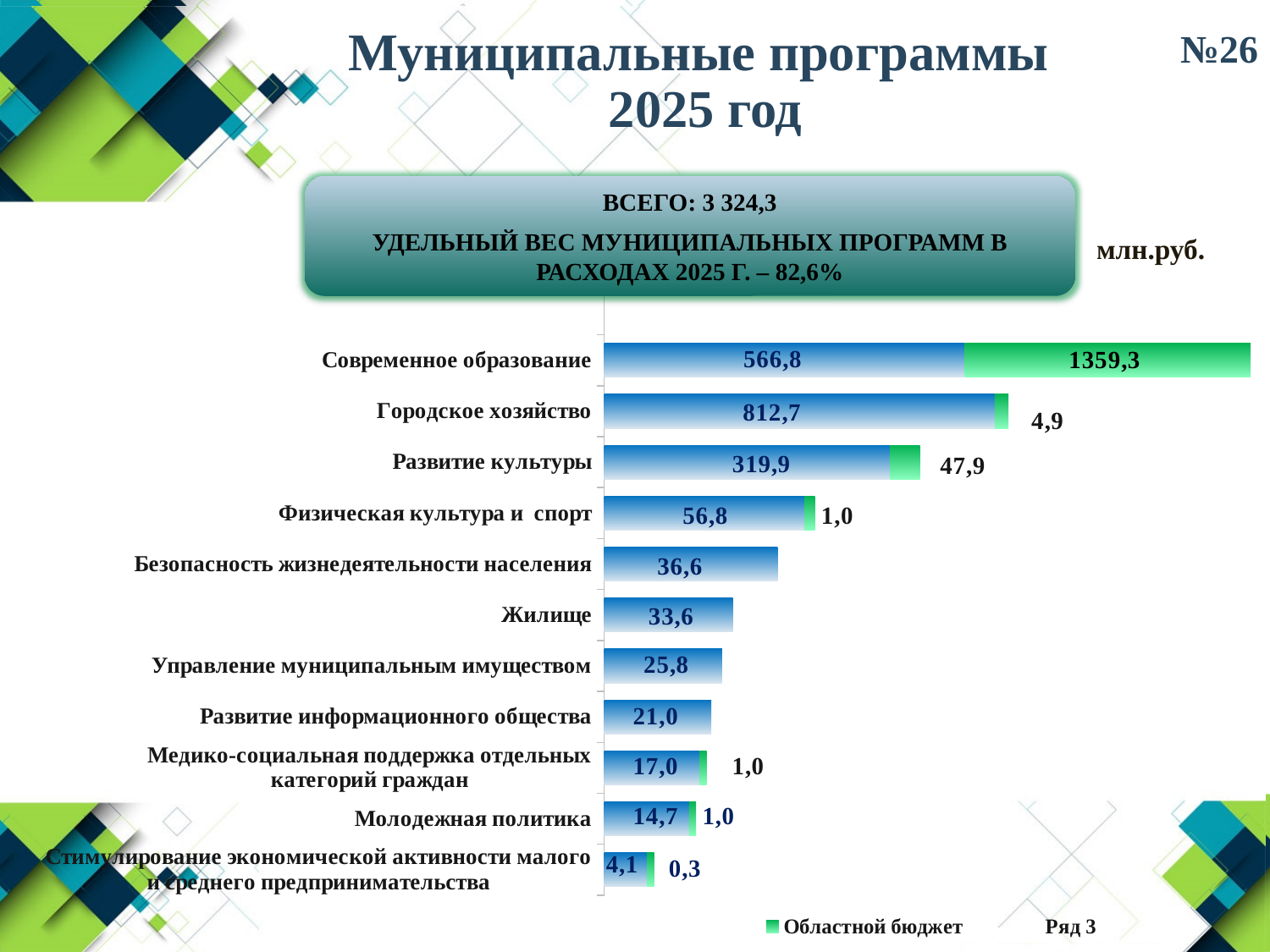
What is the blue-bar value for Современное образование? 566,8 Which category has the largest Областной бюджет (green) value? Современное образование What type of chart is shown on the slide? Bar chart What is the blue-bar value for Городское хозяйство? 812,7 What is the total of the stacked bar for Современное образование? 1926,1 What is the green (Областной бюджет) value for Современное образование? 1359,3 How many categories are shown on the chart? 11 What is the value shown for Жилище? 33,6 What is the difference between the blue-bar values for Городское хозяйство and Современное образование? 245,9 What is the Областной бюджет value for Развитие культуры? 47,9 Which is larger: the value for Безопасность жизнедеятельности населения or the value for Жилище? Безопасность жизнедеятельности населения Which category has the smallest blue-bar value? Стимулирование экономической активности малого и среднего предпринимательства